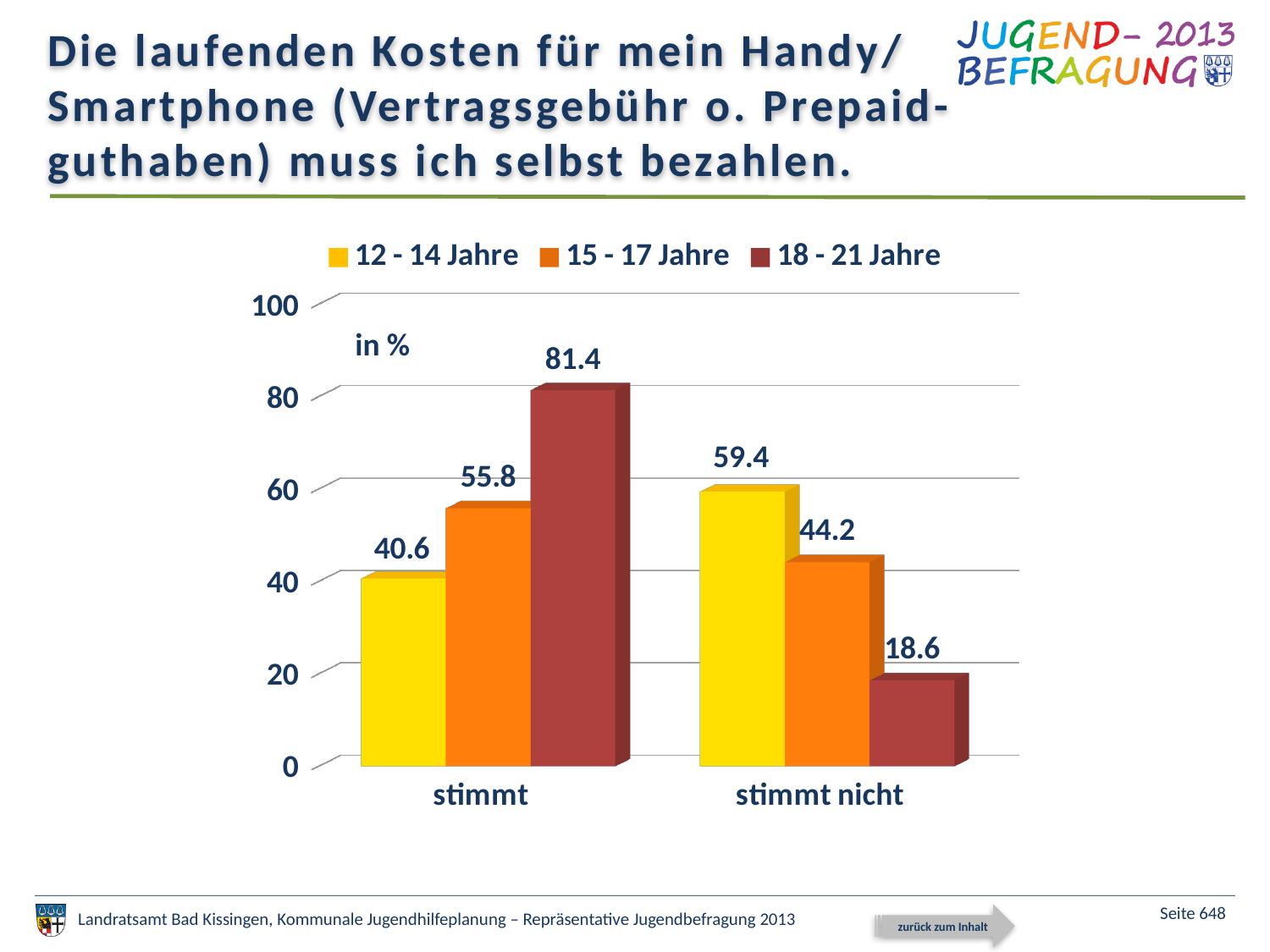
Which age group has the lowest value in the stimmt nicht category? 18 - 21 Jahre What is the difference between the 18 - 21 Jahre values for stimmt and stimmt nicht? 62.8 What is the value for the 18 - 21 Jahre series in the stimmt category? 81.4 What kind of chart is shown on the slide? bar chart How many series does the legend list? 3 Which is larger for the 12 - 14 Jahre series: stimmt or stimmt nicht? stimmt nicht Is the value for 15 - 17 Jahre in the stimmt nicht category greater or less than 40? greater Which age group has the highest value in the stimmt category? 18 - 21 Jahre What is the value for the 15 - 17 Jahre series in the stimmt category? 55.8 How many categories are shown on the x axis? 2 What is the value for the 12 - 14 Jahre series in the stimmt nicht category? 59.4 What is the difference between the 12 - 14 Jahre and 15 - 17 Jahre values in the stimmt nicht category? 15.2